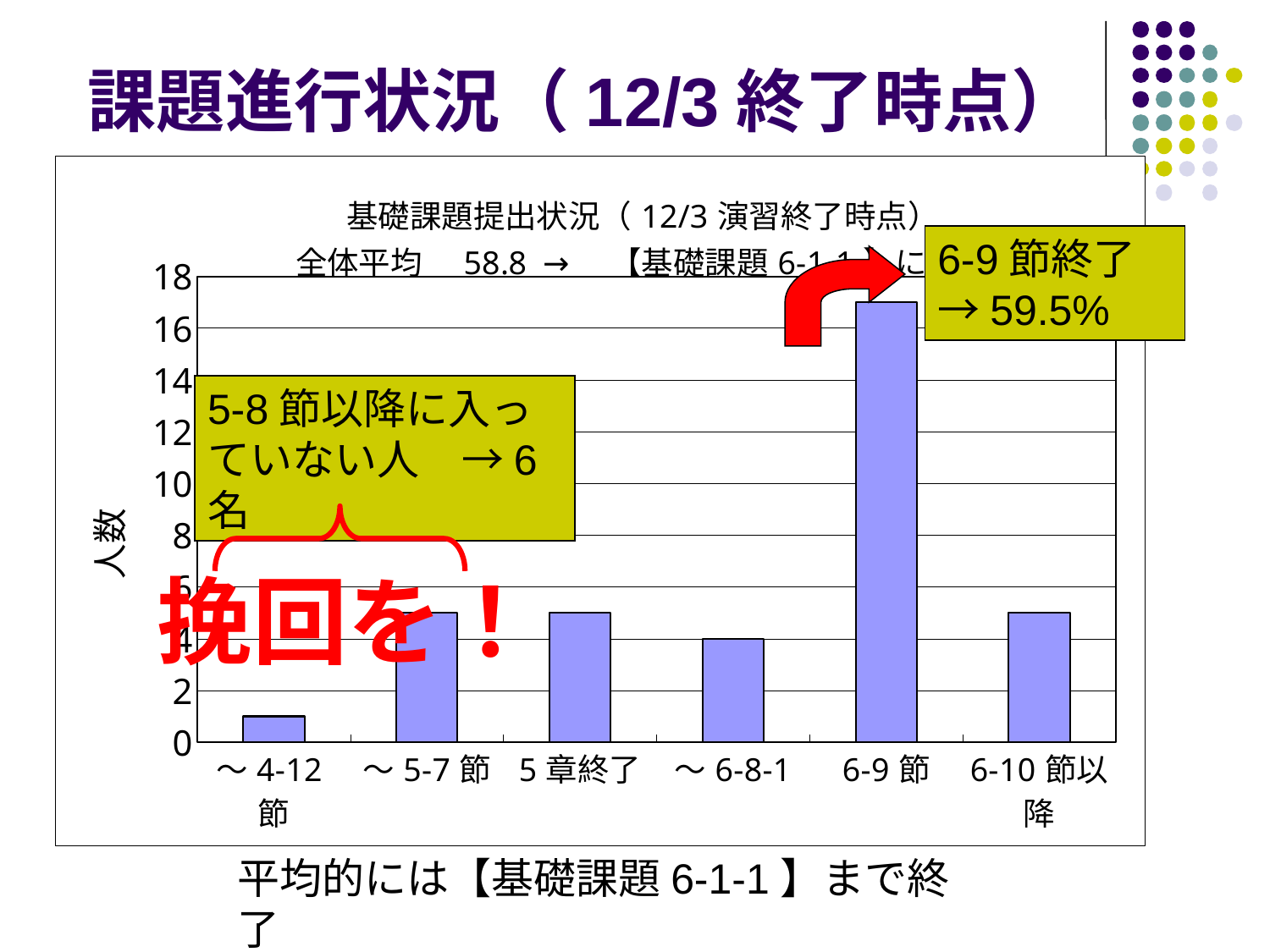
Which is larger, the value for ～4-12 節 or the value for ～6-8-1? ～6-8-1 What is the label on the vertical axis of the chart? 人数 Which category has the lowest bar? ～4-12 節 Is the value for 6-10 節以降 greater or less than 4? greater Is the value for ～5-7 節 greater or less than 4? greater Is the value for 5 章終了 greater or less than 6? less How many categories are shown on the x axis of the chart? 6 Which category has the highest bar? 6-9 節 What kind of chart is shown on the slide? bar chart Which is larger, the value for 6-9 節 or the value for 5 章終了? 6-9 節